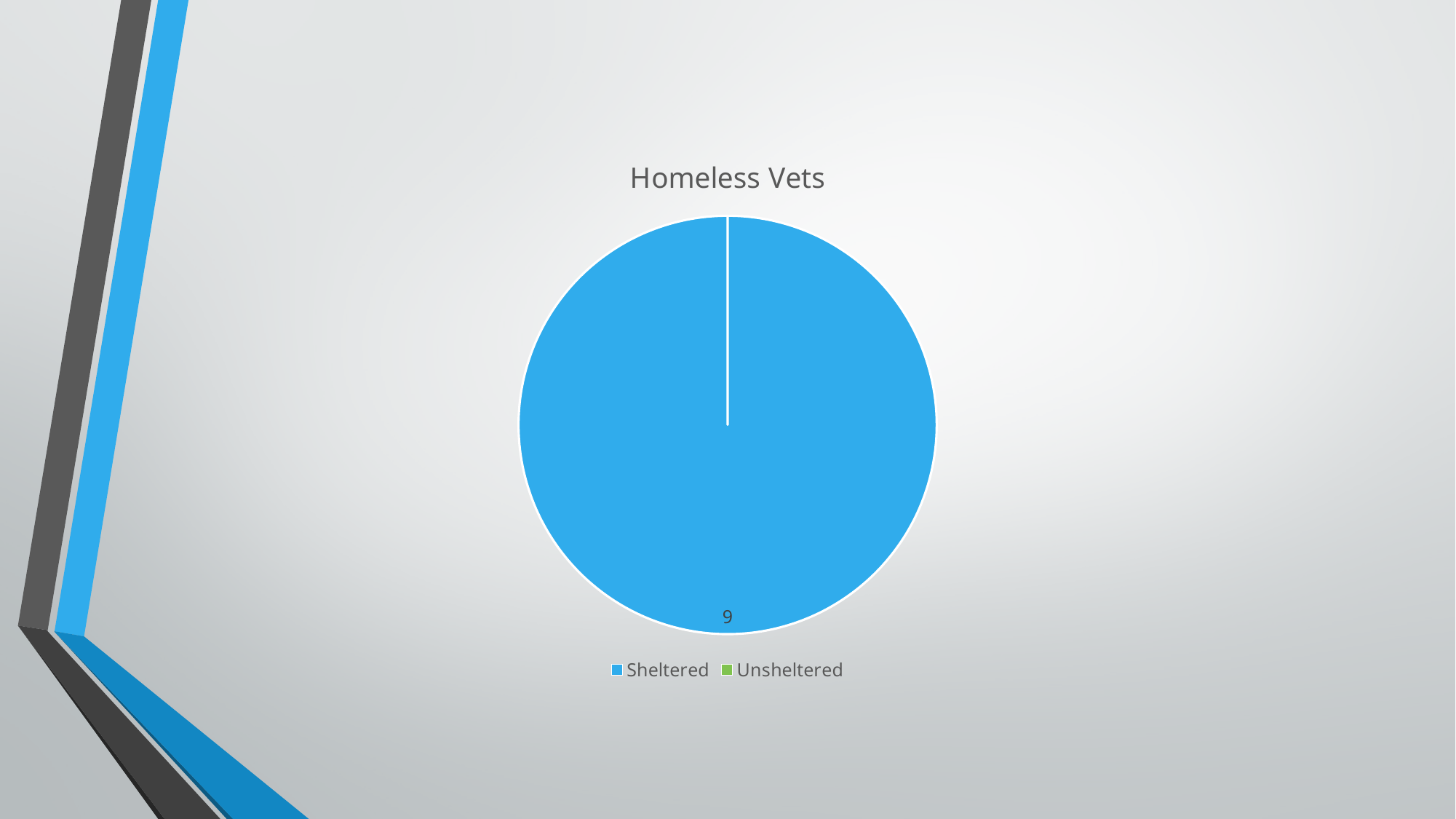
What kind of chart is shown on the slide? pie chart How many categories does the legend list? 2 What is the title of the chart? Homeless Vets Which is larger in the Homeless Vets pie chart, Sheltered or Unsheltered? Sheltered Which category has the largest slice of the Homeless Vets pie chart? Sheltered Is the value for Sheltered greater or less than 5? greater What colour represents Sheltered in the legend? blue What value is shown for Sheltered in the Homeless Vets pie chart? 9 Which category has the smallest slice of the Homeless Vets pie chart? Unsheltered